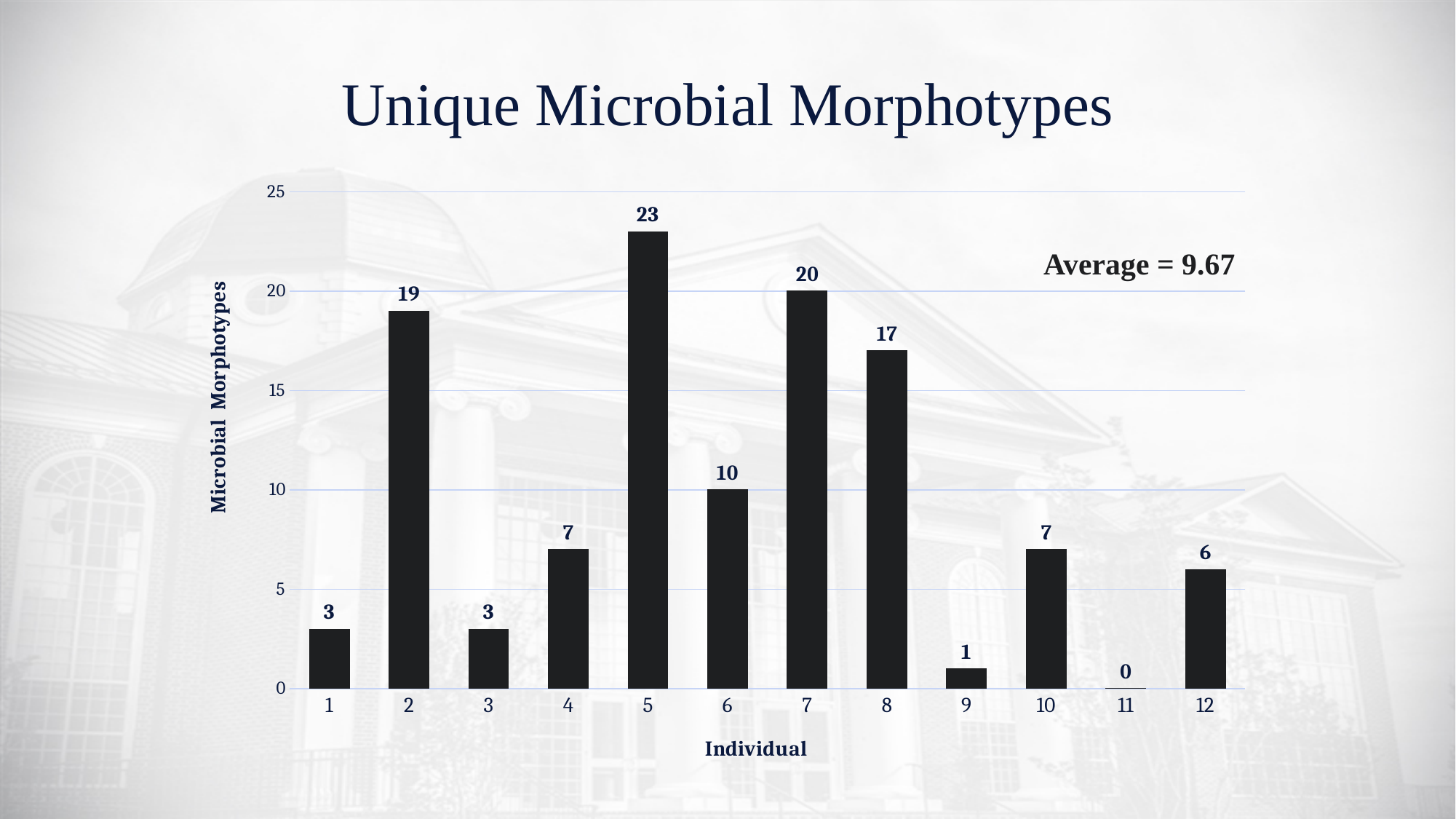
Which individual has the highest number of microbial morphotypes? 5 What is the value for individual 5? 23 What is the value for individual 11? 0 What kind of chart is shown on the slide? bar chart Which individual has the lowest number of microbial morphotypes? 11 Is the value for individual 8 greater or less than 15? greater What is the difference between the values for individual 5 and individual 9? 22 Which is larger, the value for individual 6 or the value for individual 12? individual 6 How many individuals are shown on the x axis? 12 What is the difference between the values for individual 7 and individual 2? 1 What average value is stated on the chart? 9.67 What is the value for individual 8? 17